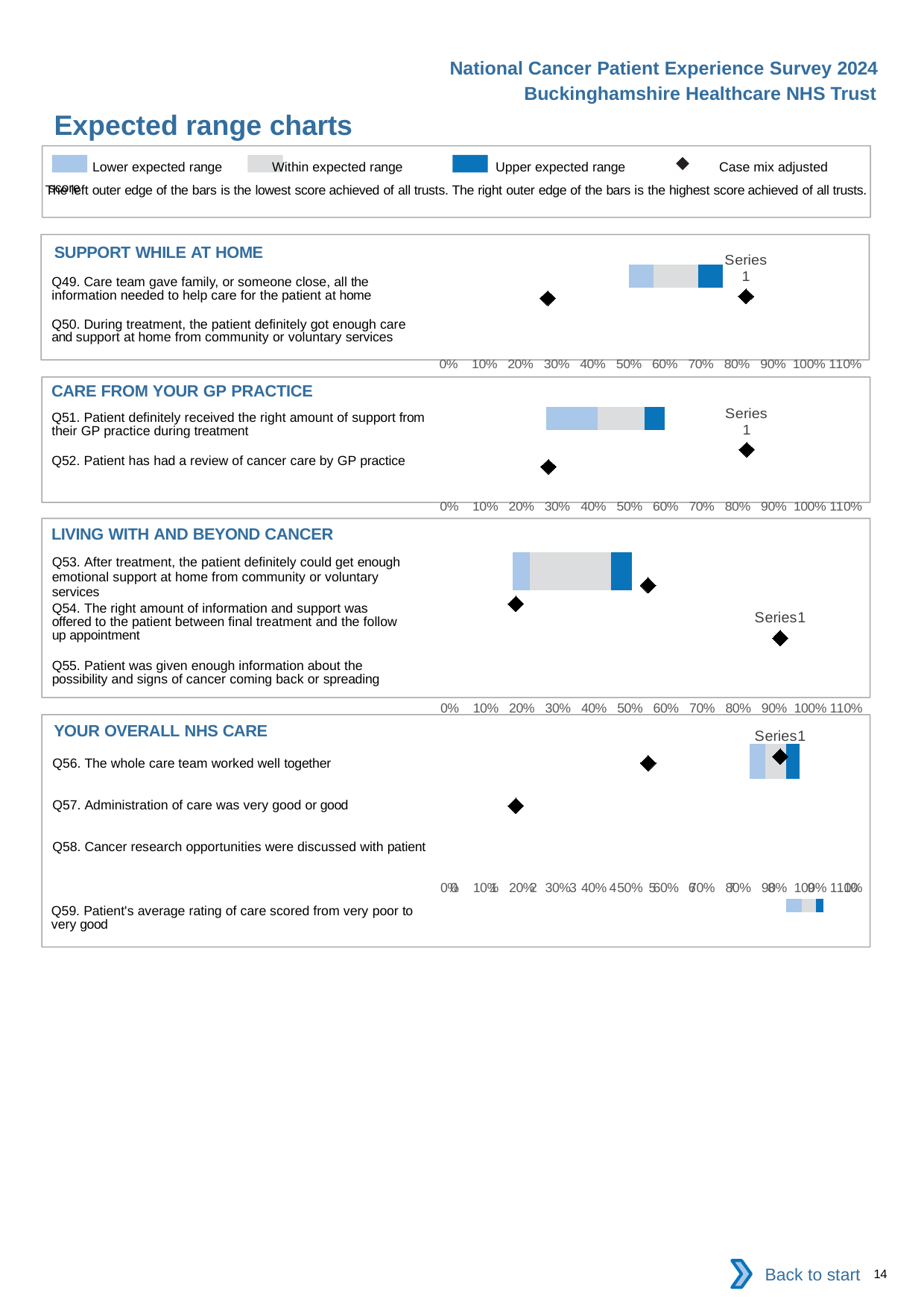
How many questions are listed in the YOUR OVERALL NHS CARE chart? 4 How many questions are listed in the LIVING WITH AND BEYOND CANCER chart? 3 How many section charts are shown on the slide? 4 According to the legend at the top of the slide, what does the black diamond marker represent? Case mix adjusted score What is the highest percentage tick shown on the x axis of the charts? 110% In the CARE FROM YOUR GP PRACTICE chart, is the left outer edge of the bar greater or less than 20%? greater What kind of chart is used in the expected range charts on this slide? bar chart In the SUPPORT WHILE AT HOME chart, is the right outer edge of the bar greater or less than 70%? greater In the LIVING WITH AND BEYOND CANCER chart, is the left outer edge of the bar greater or less than 30%? less How many entries does the legend at the top of the slide list? 4